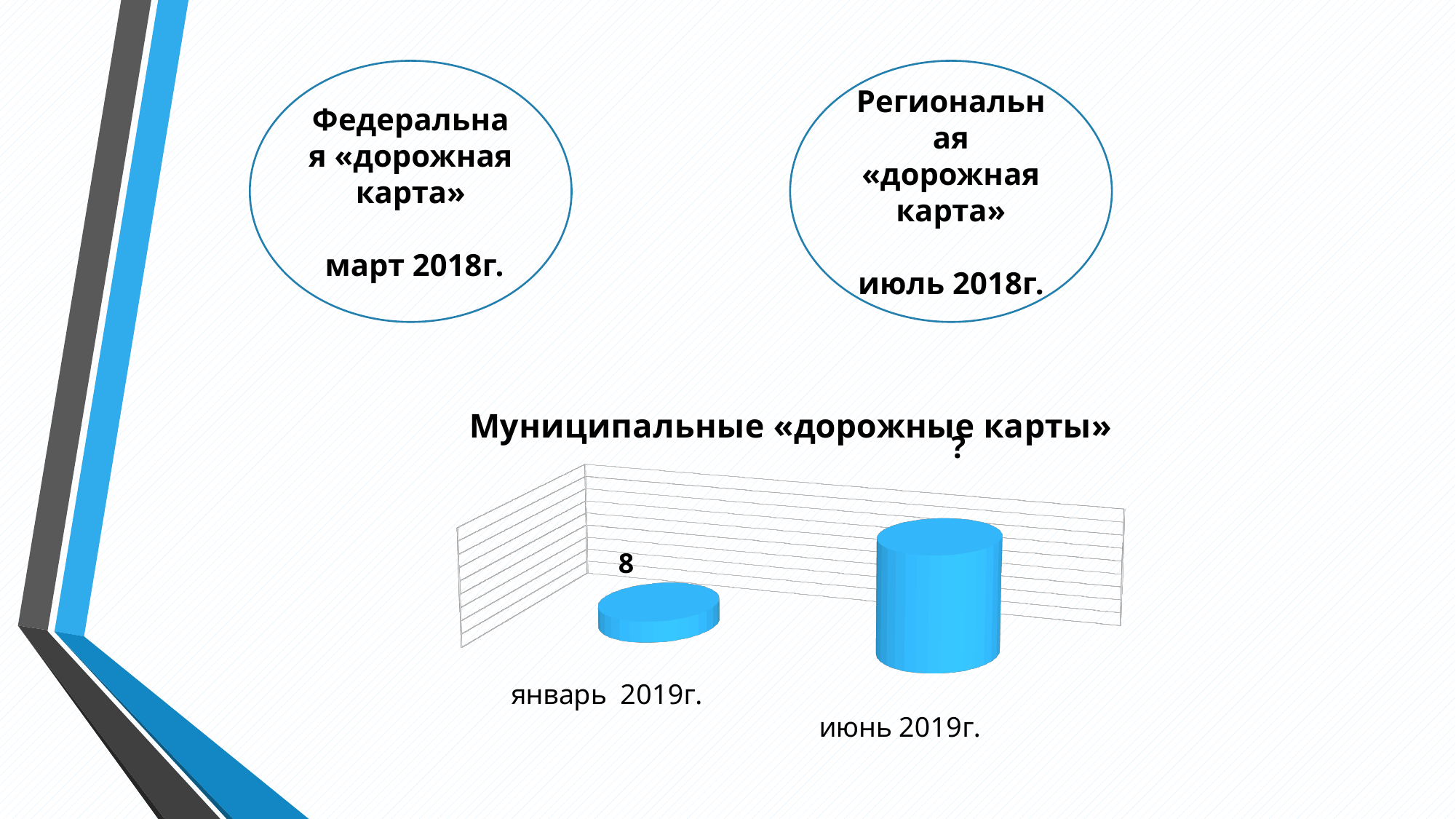
Which category has the taller bar, январь 2019г. or июнь 2019г.? июнь 2019г. Do the bars rise or fall from январь 2019г. to июнь 2019г.? rise What label is shown above the bar for июнь 2019г.? ? What is the title of the chart? Муниципальные «дорожные карты» Which category has the highest bar in the chart? июнь 2019г. How many categories are plotted in the chart? 2 What kind of chart is shown on the slide? bar chart What colour are the bars in the chart? blue What is the value shown for январь 2019г. in the chart? 8 Which category has the lowest bar in the chart? январь 2019г.